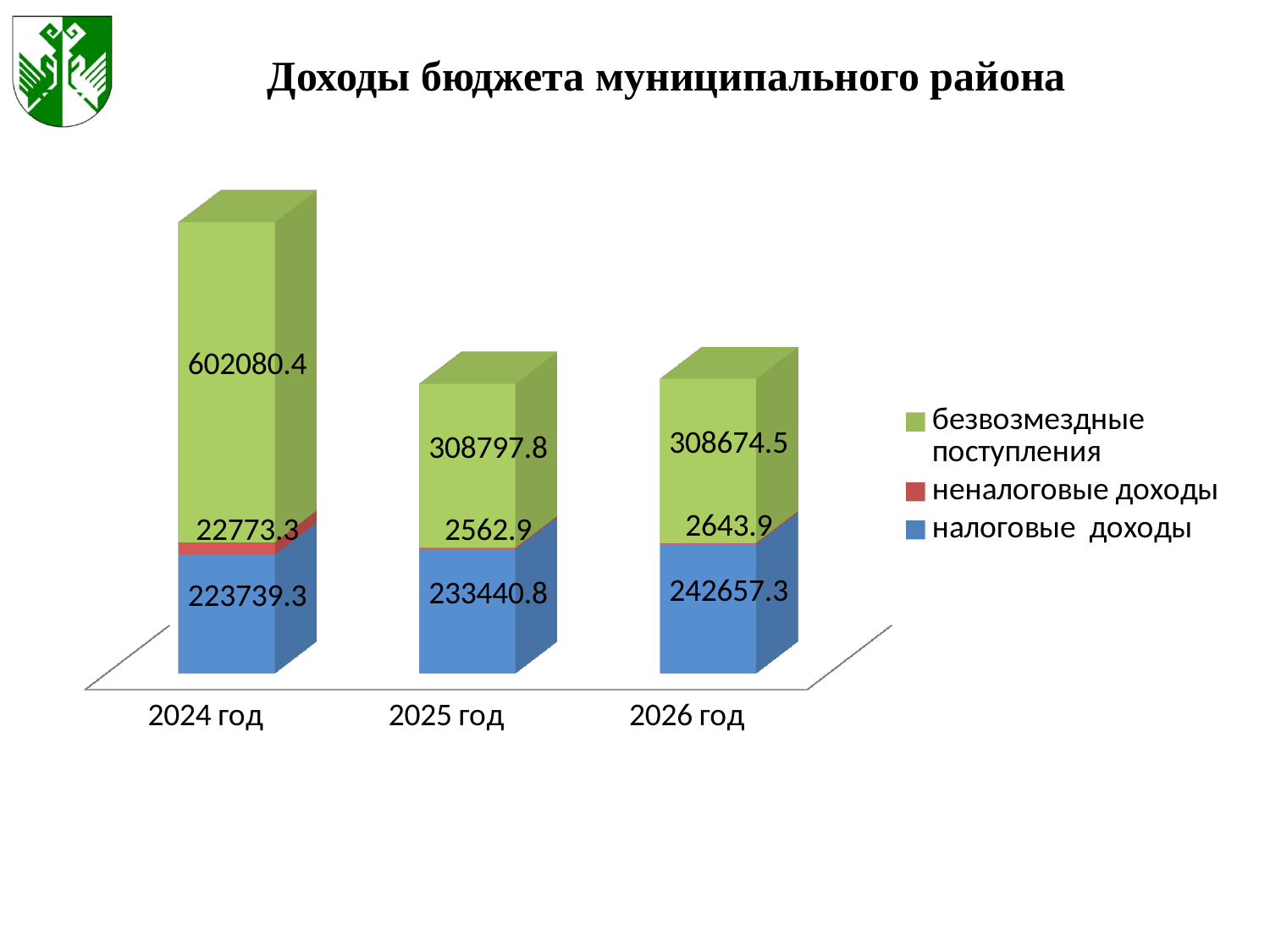
Do the values of налоговые доходы rise or fall from 2024 год to 2026 год? rise What is the difference between налоговые доходы in 2026 год and in 2024 год? 18918.0 How many series does the legend list? 3 Which is larger: налоговые доходы in 2025 год or in 2026 год? 2026 год What kind of chart is shown on the slide? stacked bar chart How many years are shown on the x axis? 3 In which year is the value of безвозмездные поступления the highest? 2024 год What is the value of налоговые доходы for 2024 год? 223739.3 What is the value of безвозмездные поступления for 2025 год? 308797.8 What is the total of the stacked bar for 2025 год? 544801.5 In which year is the value of неналоговые доходы the lowest? 2025 год What is the value of неналоговые доходы for 2026 год? 2643.9